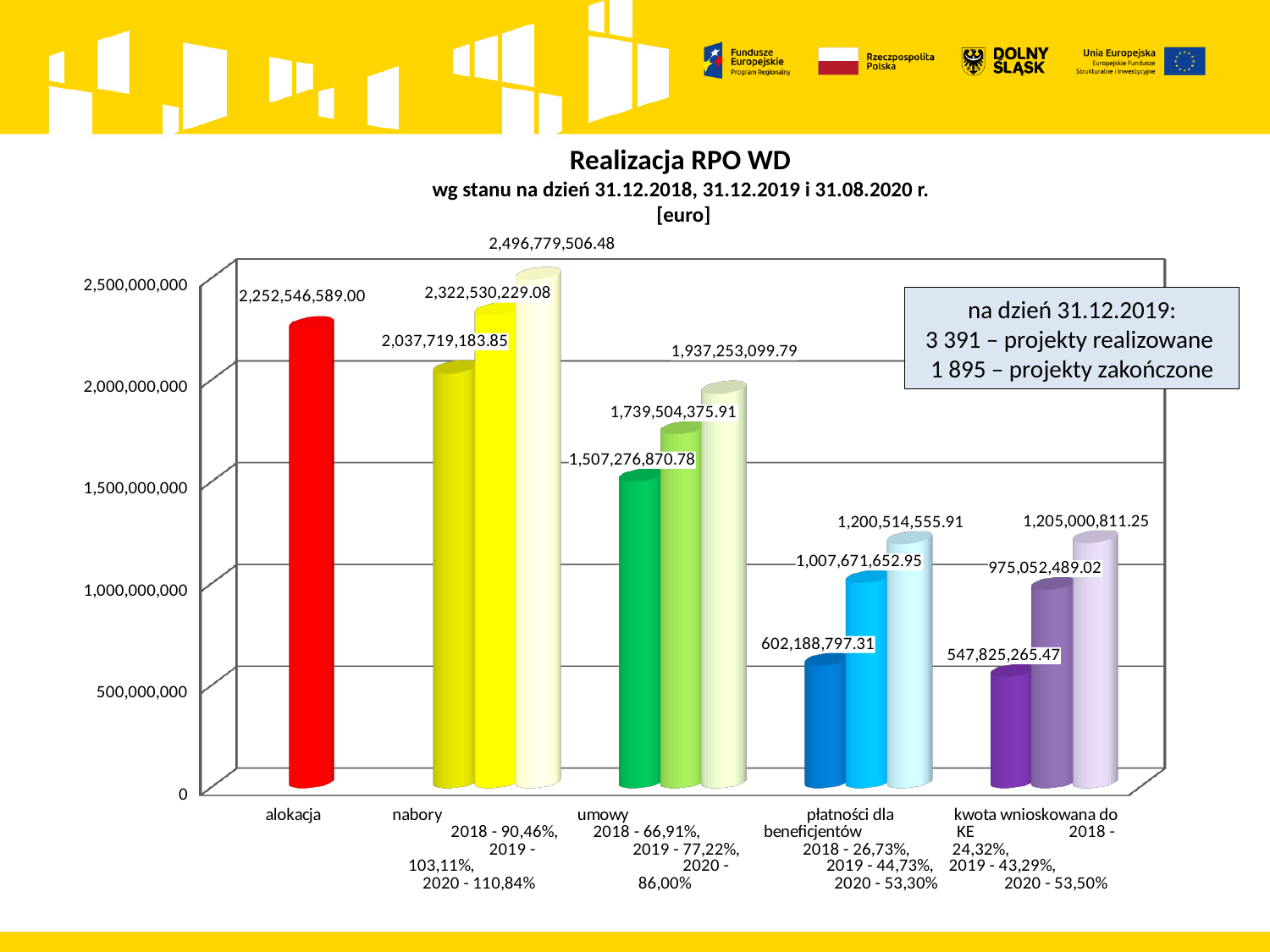
What is the value of the shortest bar in the płatności dla beneficjentów group? 602,188,797.31 Which category group contains the highest bar on the chart? nabory What is the difference between the tallest bar in the nabory group (2,496,779,506.48) and the alokacja bar (2,252,546,589.00)? 244,232,917.48 What type of chart is shown on the slide? bar chart What is the value of the alokacja bar? 2,252,546,589.00 Which is larger: the tallest bar in the umowy group or the alokacja bar? the alokacja bar How many category groups are shown on the x axis? 5 What is the value of the lowest bar on the chart? 547,825,265.47 What is the value of the tallest bar in the nabory group? 2,496,779,506.48 Within the umowy group, do the bars rise or fall from left to right? rise Is the value of the tallest bar in the kwota wnioskowana do KE group greater or less than 1,500,000,000? less What is the value of the shortest bar in the umowy group? 1,507,276,870.78